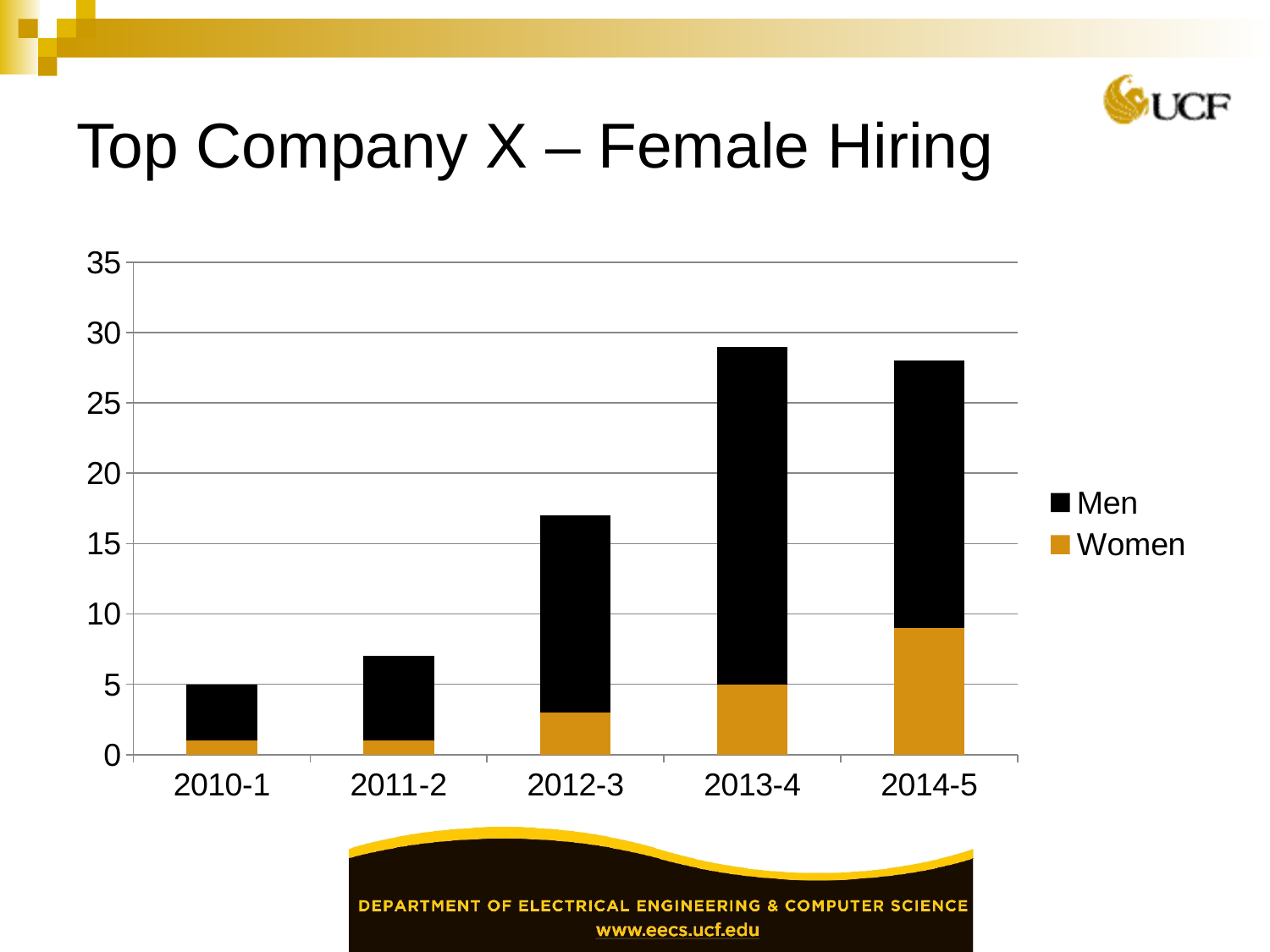
Which year has the highest Women value? 2014-5 What are the two series named in the legend? Men and Women How many series does the legend list? 2 What is the Women value for 2013-4? 5 How many year categories are shown on the x axis? 5 What is the total height of the stacked bar for 2010-1? 5 What kind of chart is shown on the slide? bar chart Is the total for 2011-2 greater or less than 10? less Is the total for 2013-4 greater or less than 25? greater Which year has the lowest total stacked bar? 2010-1 What is the title of the slide containing the chart? Top Company X – Female Hiring Is the Women value for 2014-5 greater or less than 5? greater